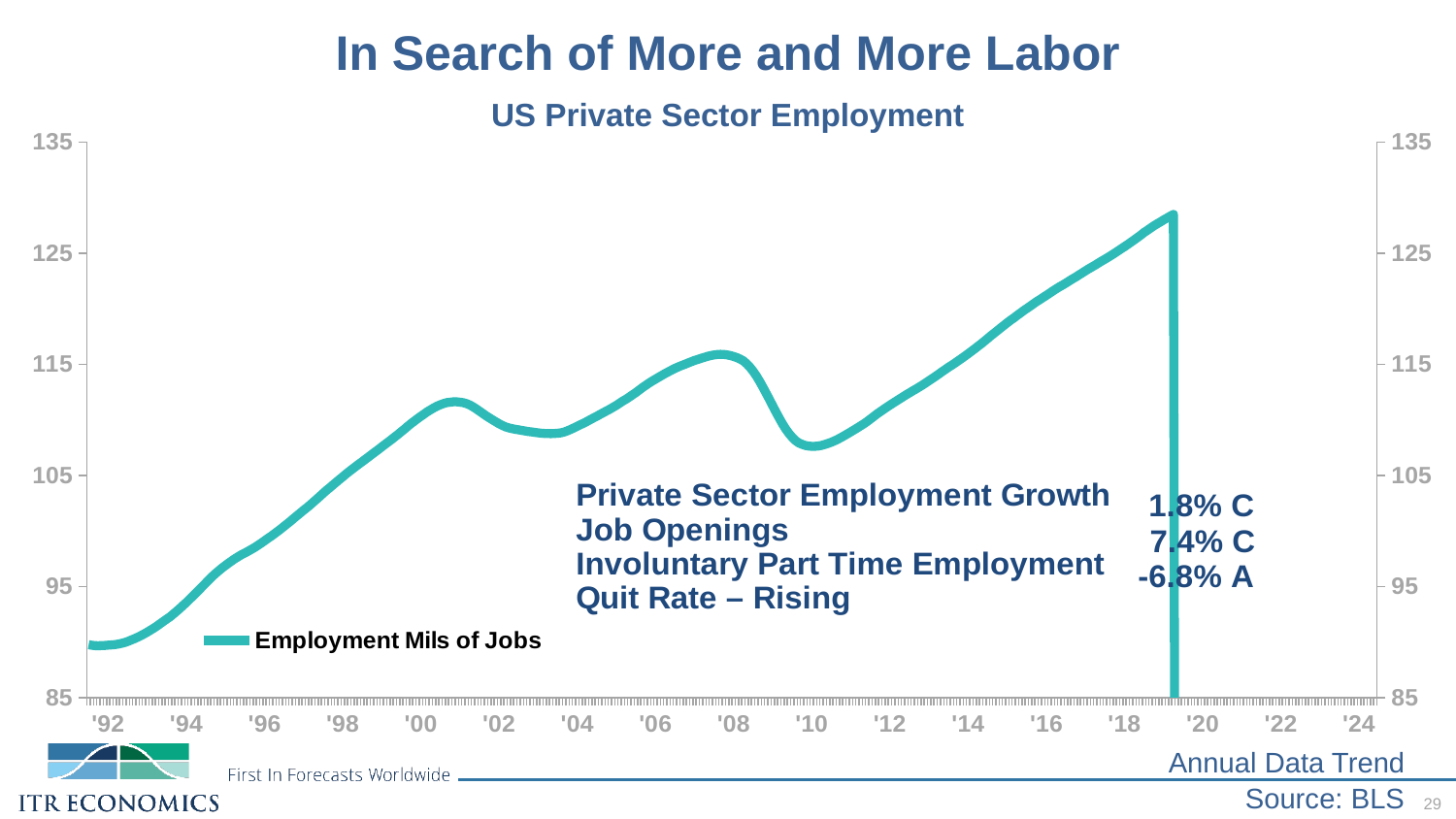
Is the value for '00 greater or less than 105? greater How many series does the legend list? 1 Is the value for '16 greater or less than 115? greater What is the title of the chart? US Private Sector Employment Is the value for '04 greater or less than 115? less Overall, does employment rise or fall from '92 to '18? rise What kind of chart is shown on the slide? Line chart Which year has the larger employment value, '92 or '18? '18 What series name is shown in the chart legend? Employment Mils of Jobs